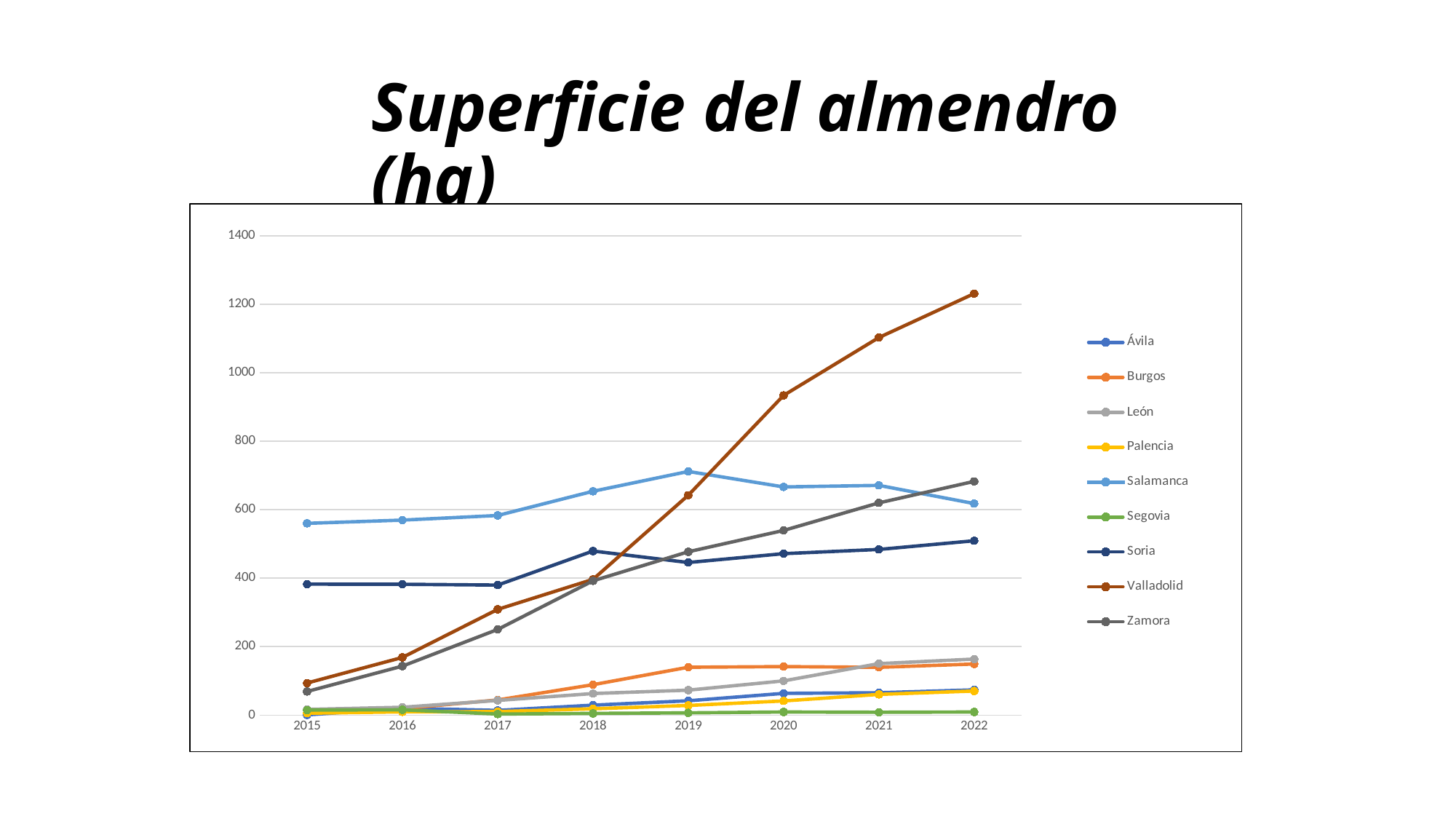
How many series does the legend list? 9 Is the value for Valladolid in 2022 greater or less than 1000? greater Which province has the lowest value in 2022? Segovia Which province has the highest value in 2022? Valladolid Which province has the highest value in 2015? Salamanca How many years are shown on the x axis? 8 What type of chart is shown on the slide? line chart Is the value for Salamanca in 2019 greater or less than 600? greater Is the value for Zamora in 2015 greater or less than 200? less In 2022, which is larger: Zamora or Salamanca? Zamora Does the Valladolid line rise or fall from 2015 to 2022? rise What is the title of the chart? Superficie del almendro (ha)